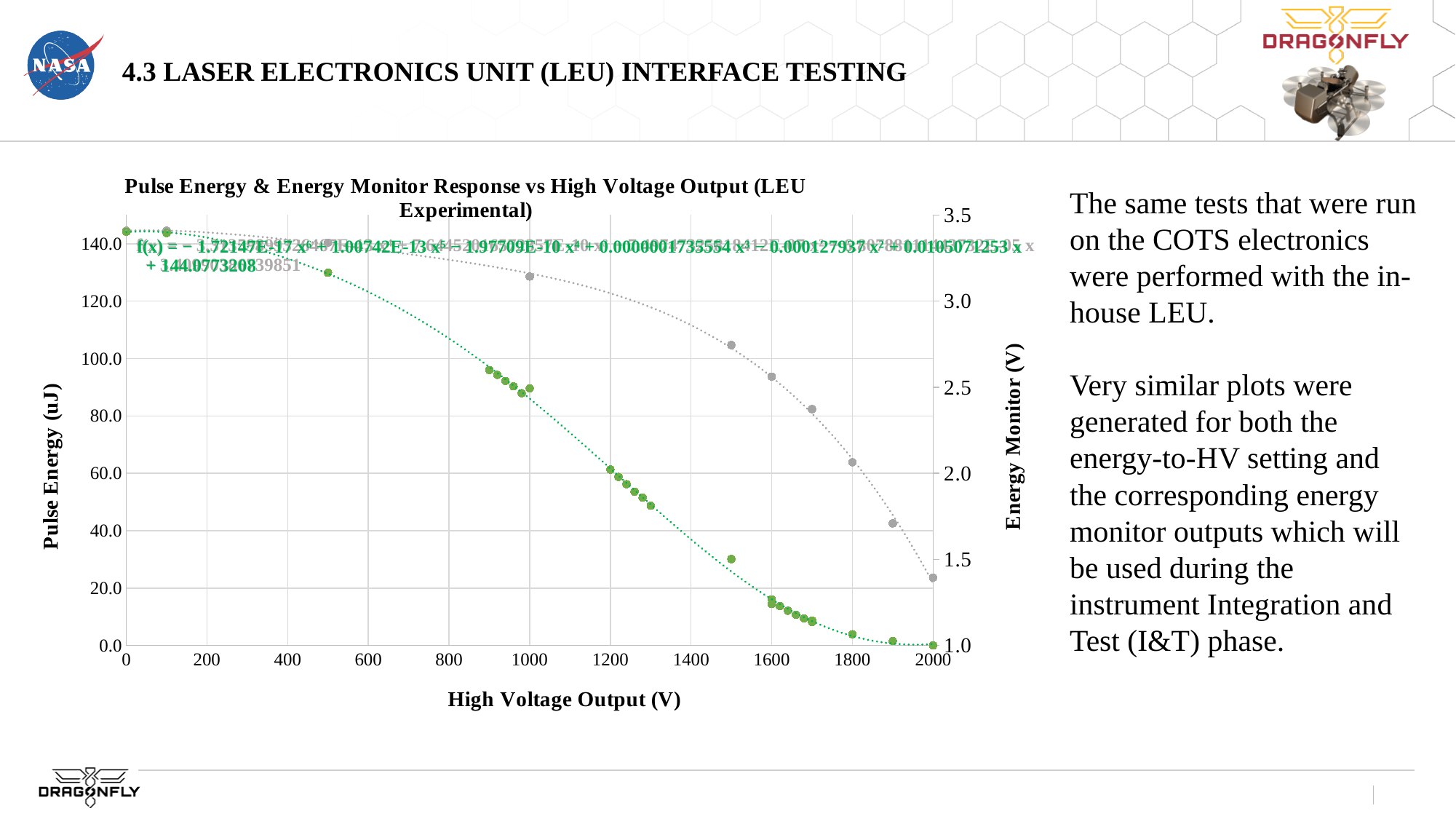
What kind of chart is shown on the slide? scatter chart Is the Energy Monitor value at a High Voltage Output of 2000 V greater or less than 1.5? less What is the title of the chart? Pulse Energy & Energy Monitor Response vs High Voltage Output (LEU Experimental) Is the Energy Monitor value at a High Voltage Output of 1000 V greater or less than 3.0? greater As High Voltage Output increases along the x axis, does Pulse Energy rise or fall? fall Is the Pulse Energy at a High Voltage Output of 1000 V greater or less than 100? less Which has the larger Pulse Energy: a High Voltage Output of 500 V or 1500 V? 500 V At which High Voltage Output value is the Pulse Energy lowest? 2000 V What is the label of the x axis of the chart? High Voltage Output (V) As High Voltage Output increases along the x axis, does the Energy Monitor value rise or fall? fall